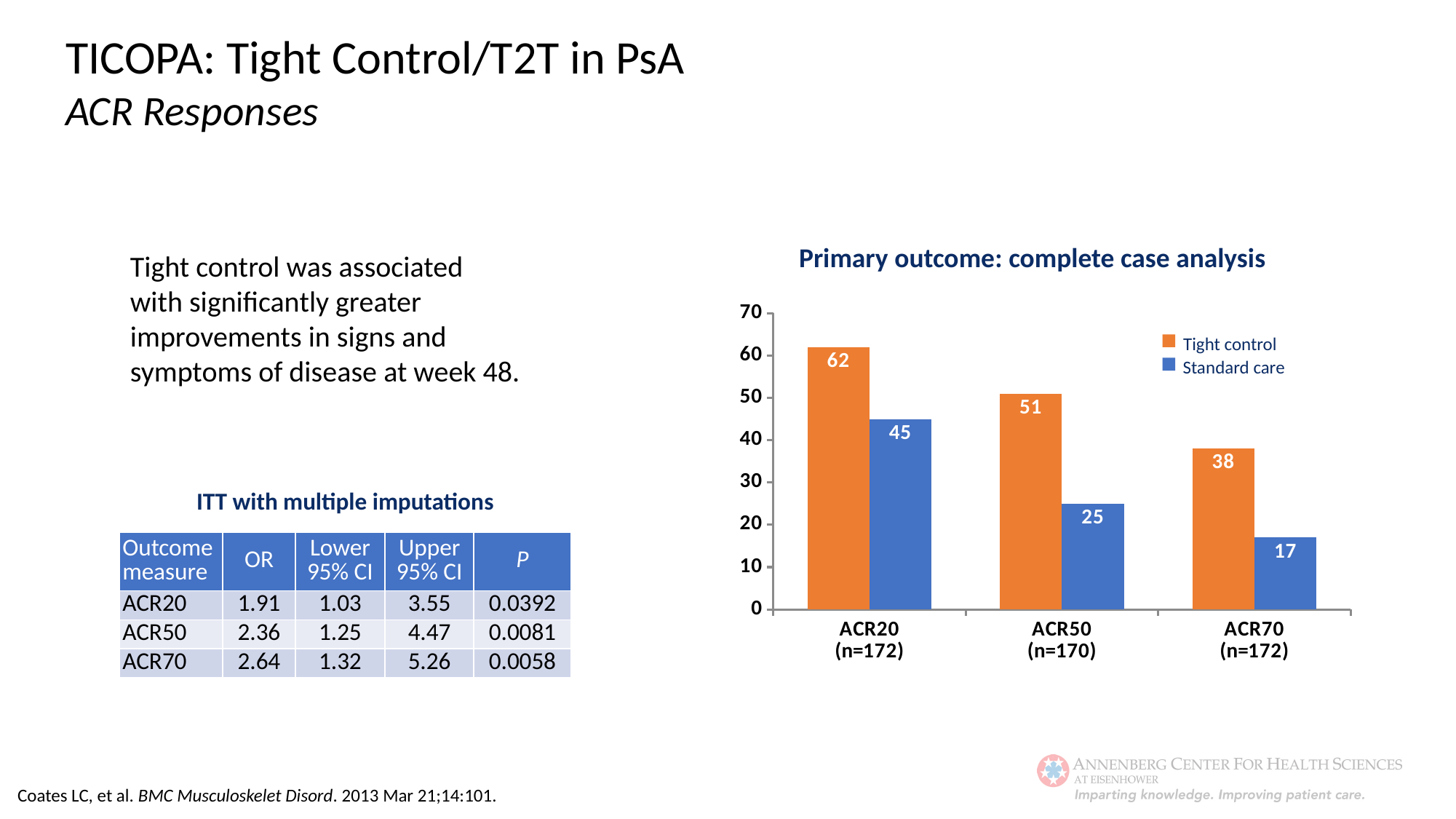
What is the Tight control value for ACR20 (n=172)? 62 How many categories are shown on the x axis of the chart? 3 Which is larger for ACR70 (n=172): Tight control or Standard care? Tight control What is the title of the chart? Primary outcome: complete case analysis Is the Standard care value for ACR20 (n=172) greater or less than 40? greater What is the Standard care value for ACR50 (n=170)? 25 What is the Standard care value for ACR70 (n=172)? 17 How many series does the chart legend list? 2 Which category has the lowest Standard care value? ACR70 (n=172) What is the difference between the Tight control and Standard care values for ACR50 (n=170)? 26 What kind of chart is shown on the slide? Bar chart Which category has the highest Tight control value? ACR20 (n=172)